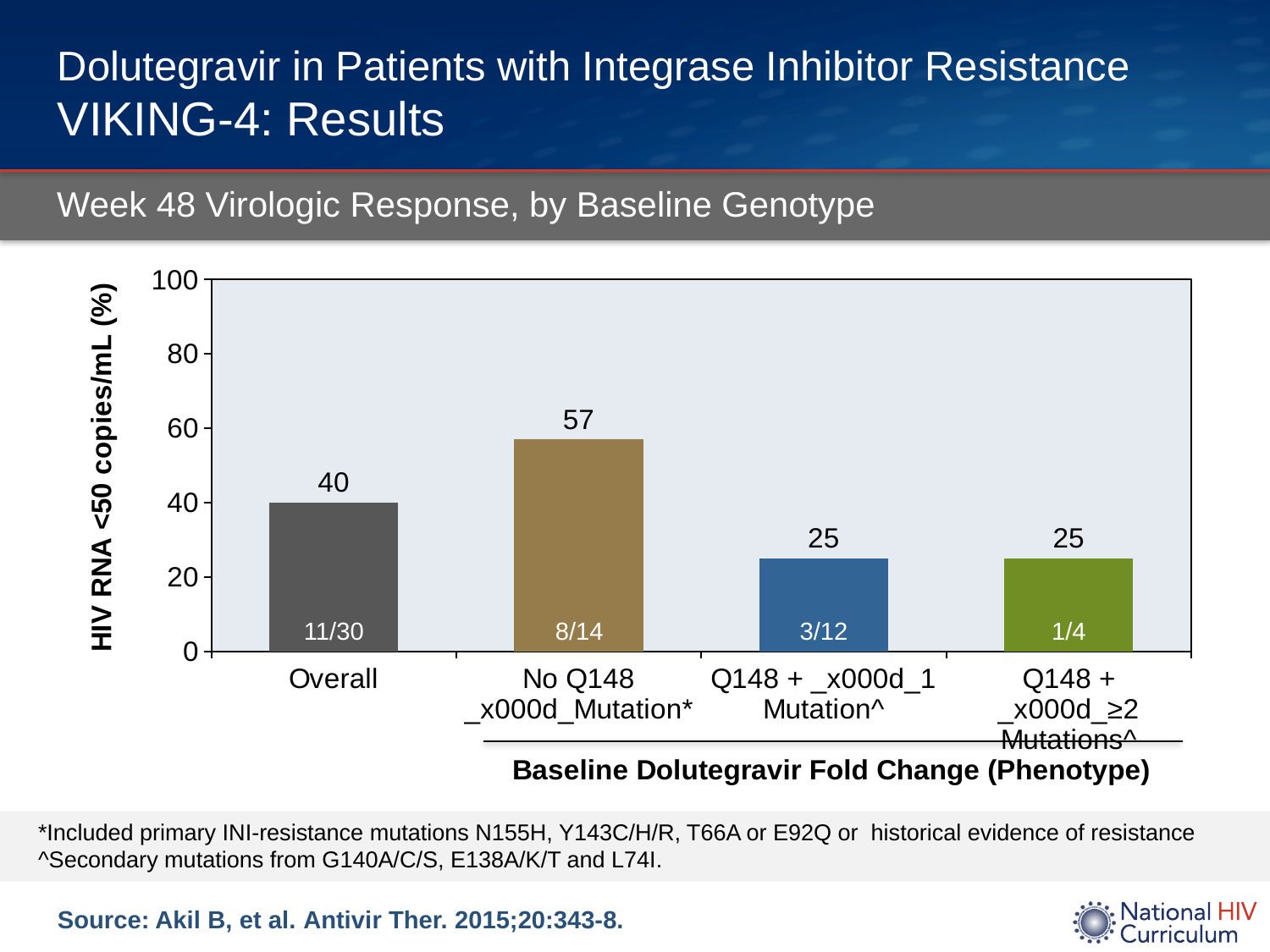
How many groups are plotted on the chart? 4 What fraction of patients is printed inside the Q148 + ≥2 Mutations bar? 1/4 What kind of chart is shown on the slide? bar chart Which group has the highest virologic response? No Q148 Mutation What is the value shown for the Q148 + 1 Mutation group? 25 What is the label of the y axis? HIV RNA <50 copies/mL (%) What is the difference between the No Q148 Mutation value and the Overall value? 17 What fraction of patients is printed inside the Overall bar? 11/30 Which is larger, the value for Overall or the value for Q148 + 1 Mutation? Overall What is the value shown for the No Q148 Mutation group? 57 Is the value for the No Q148 Mutation group greater or less than 60? less What is the Week 48 virologic response value for the Overall group? 40